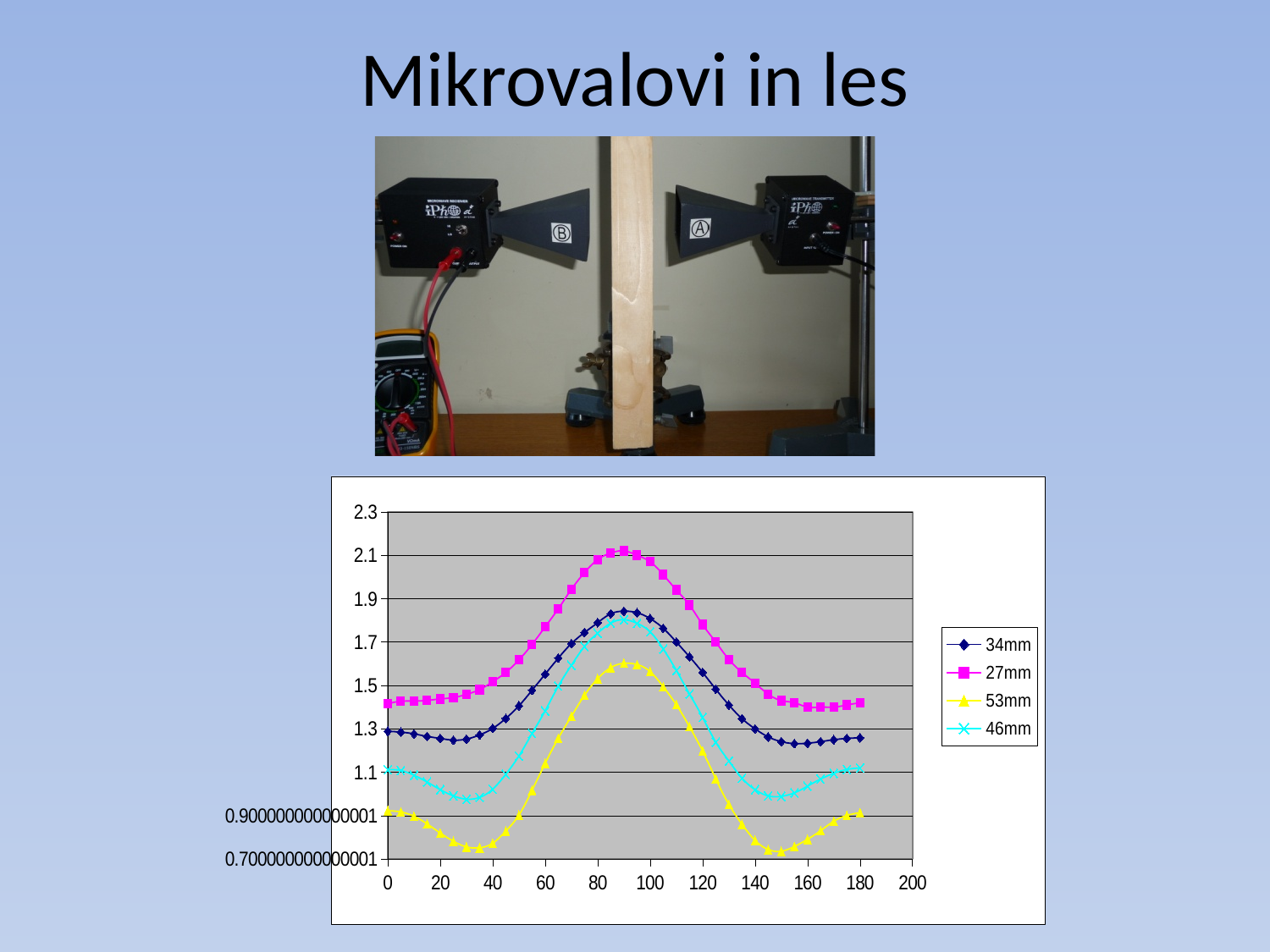
Is the value of the 53mm series at x = 150 greater or less than 0.9? less Which series reaches the highest value on the chart? 27mm Which series has the lowest values on the chart? 53mm Is the value of the 34mm series at x = 0 greater or less than 1.5? less What kind of chart is shown on the slide? line chart Is the value of the 27mm series at x = 90 greater or less than 1.9? greater How many series does the chart legend list? 4 Do the values of the 27mm series rise or fall as x goes from 0 to 90? rise At x = 0, which series has the larger value, 27mm or 34mm? 27mm At x = 90, which series has the larger value, 46mm or 53mm? 46mm Which series is drawn with yellow triangle markers? 53mm